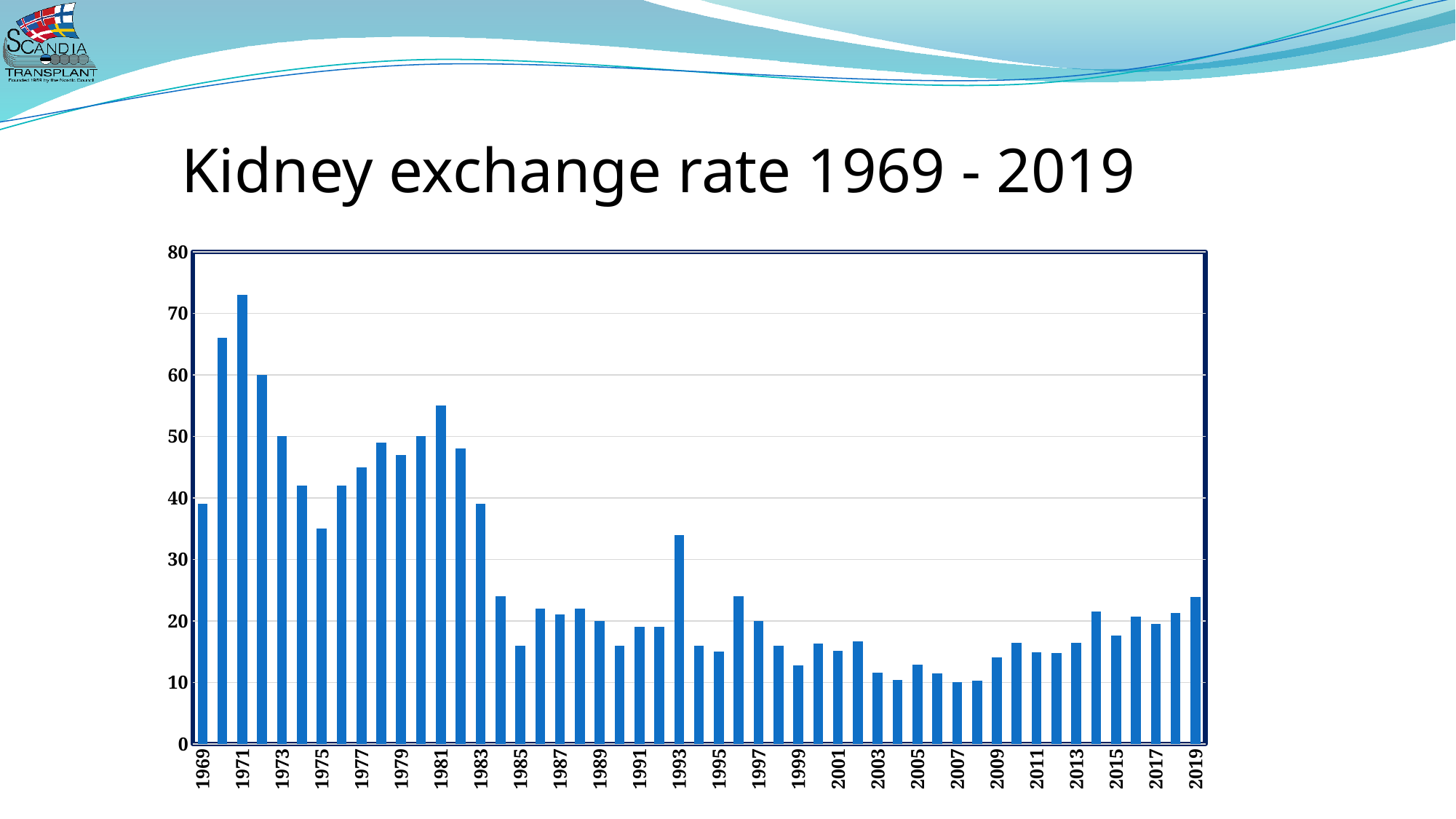
Is the value for 1985 greater or less than 20? less What is the kidney exchange rate for 1972? 60 Which year has the larger value, 1970 or 1972? 1970 Which year has the highest kidney exchange rate? 1971 What is the title of the chart? Kidney exchange rate 1969 - 2019 Is the value for 1971 greater or less than 70? greater Is the value for 2019 greater or less than 20? greater Overall, do the values rise or fall from 1969 to 2019? Fall What is the kidney exchange rate for 1973? 50 How many years (bars) are plotted in the chart? 51 What kind of chart is shown on the slide? Bar chart